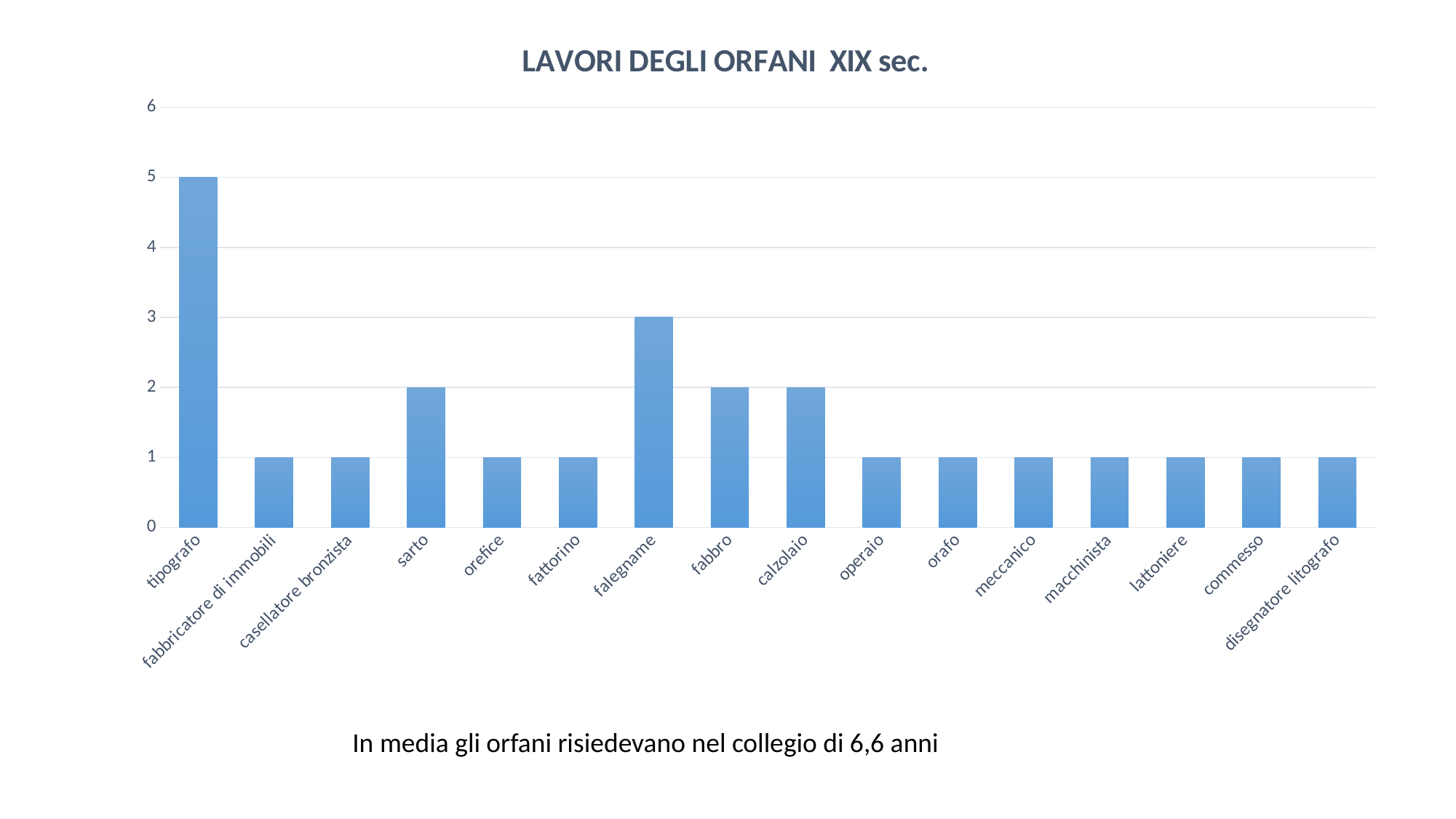
What is the value for sarto? 2 What type of chart is shown on the slide? bar chart Which is larger, the value for fabbro or the value for orefice? fabbro What is the value for tipografo? 5 What is the value for calzolaio? 2 How many categories are shown on the x axis of the chart? 16 Which category has the highest value in the chart? tipografo What is the difference between the values for tipografo and falegname? 2 What is the title of the chart? LAVORI DEGLI ORFANI XIX sec. Is the value for tipografo greater or less than 4? greater What is the value for lattoniere? 1 What is the value for falegname? 3